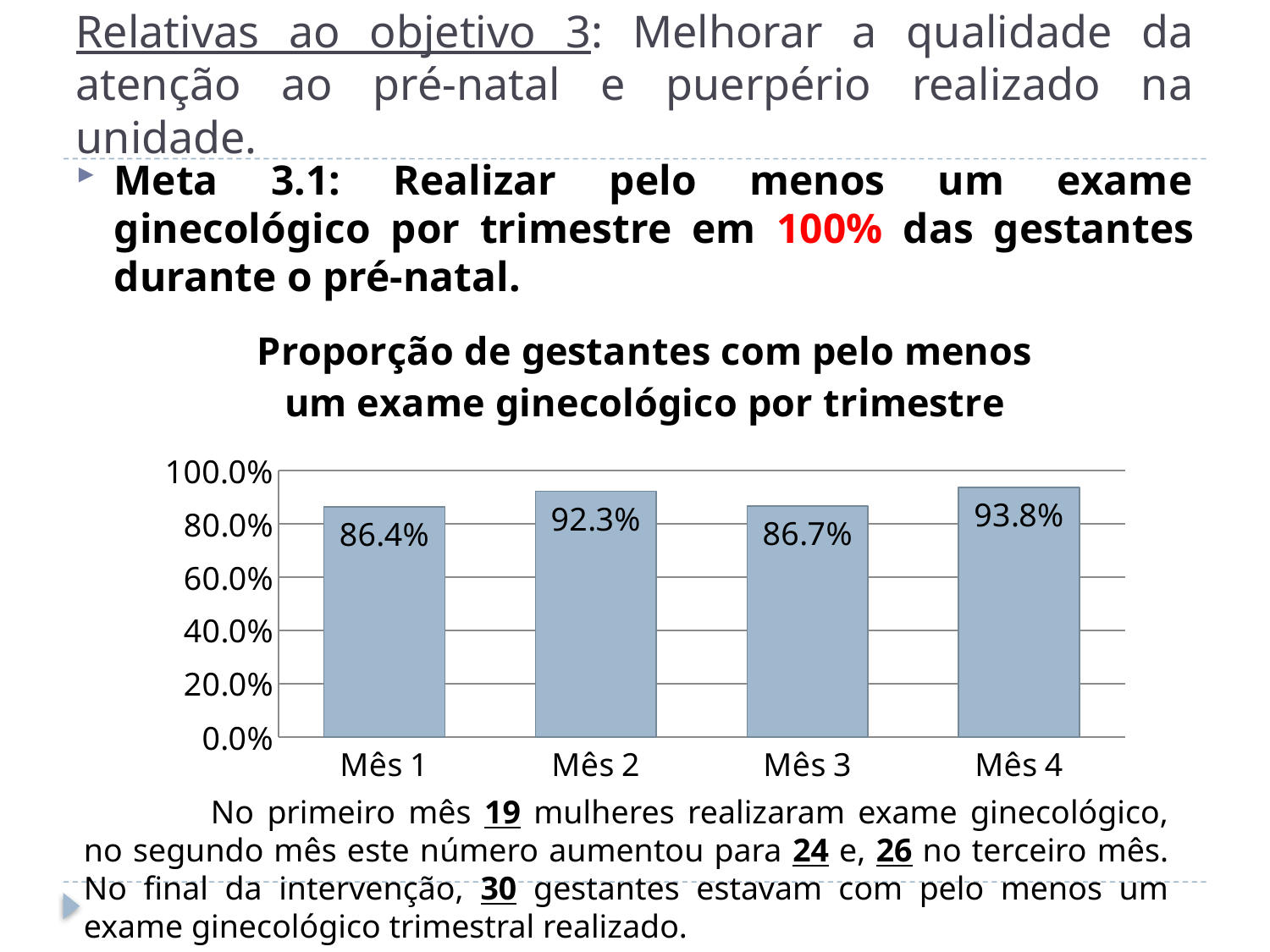
What is the value for Mês 1? 86.4% Which month has the lowest value? Mês 1 What kind of chart is shown? Bar chart Which month has the highest value? Mês 4 What is the value for Mês 2? 92.3% What is the value for Mês 3? 86.7% What is the value for Mês 4? 93.8% How many months are shown on the chart? 4 Which is larger, the value for Mês 2 or the value for Mês 3? Mês 2 What is the difference between the values for Mês 2 and Mês 3? 5.6% What is the title of the chart? Proporção de gestantes com pelo menos um exame ginecológico por trimestre What is the difference between the values for Mês 4 and Mês 1? 7.4%